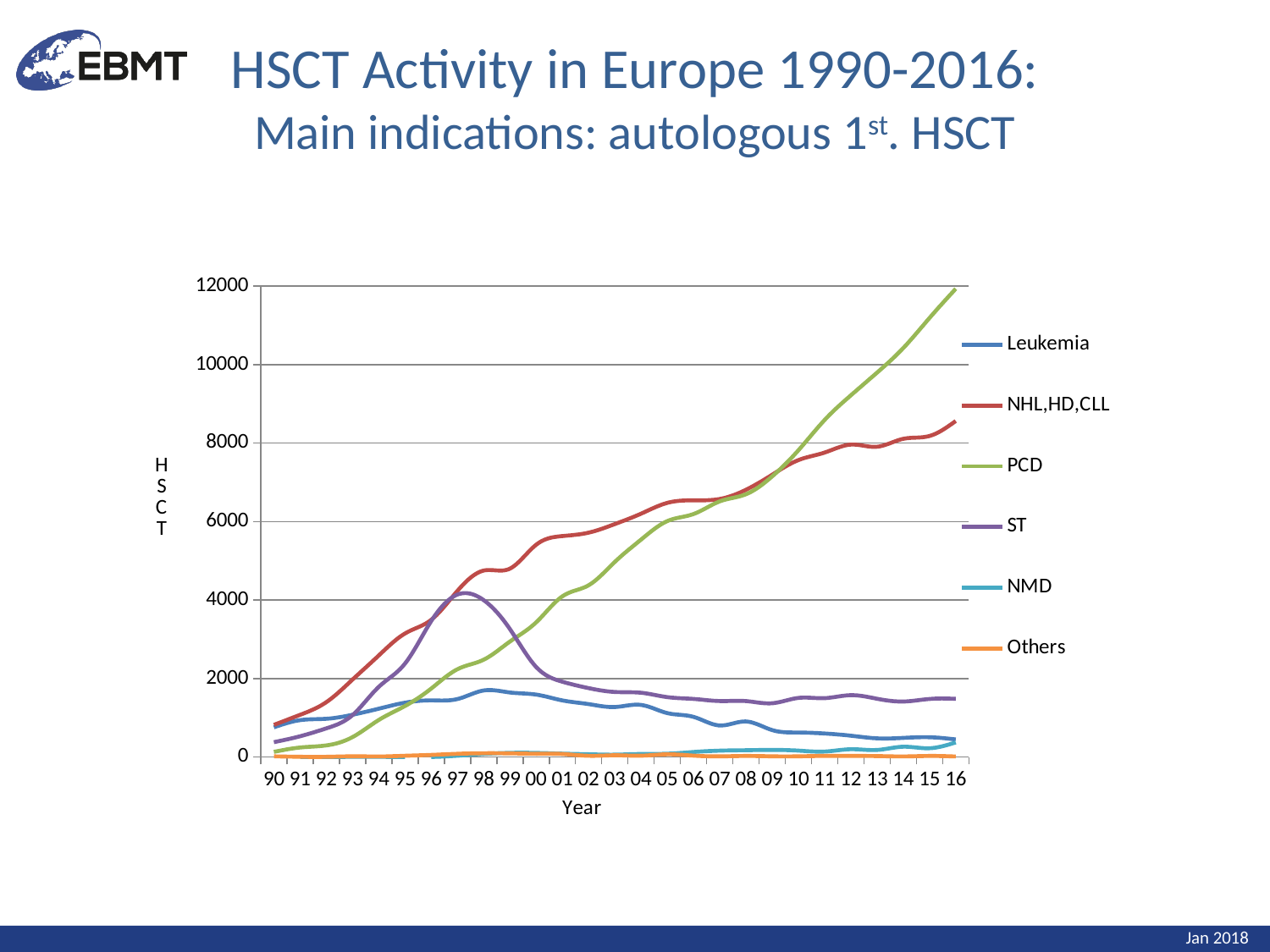
Which series has the highest value in 16? PCD Is the value for PCD in 16 greater or less than 10000? greater What is the label on the x axis? Year In 97, which is larger: ST or Leukemia? ST Does the PCD series rise or fall from 90 to 16? rise Which series has the highest value in 00? NHL,HD,CLL Is the value for NHL,HD,CLL in 16 greater or less than 10000? less How many series does the legend list? 6 How many years are plotted along the x axis? 27 What kind of chart is shown on the slide? line chart Which series has the lowest value in 16? Others Is the value for ST in 16 greater or less than 2000? less